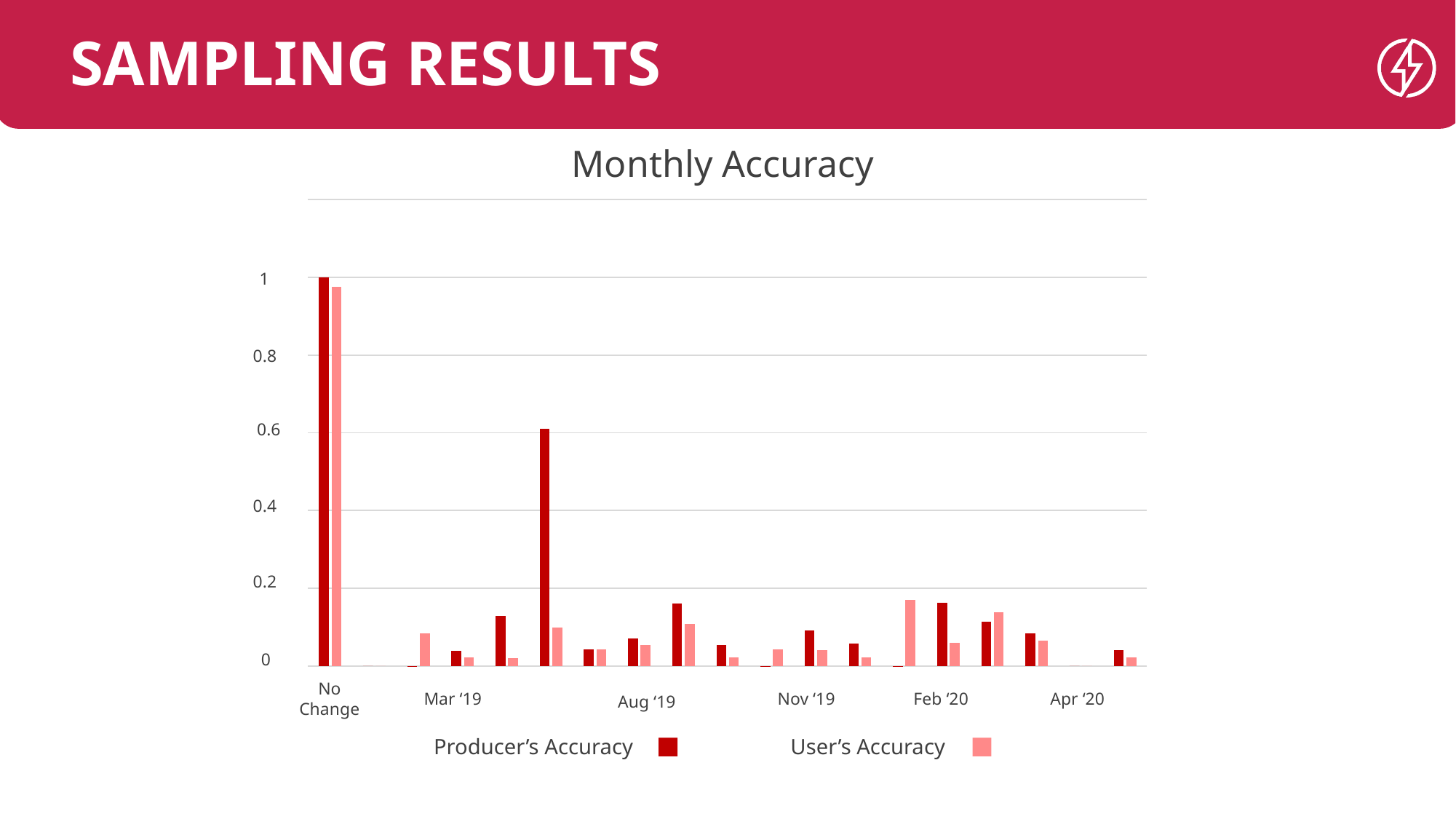
Is the Producer's Accuracy for No Change greater or less than 0.8? greater Which category has the highest Producer's Accuracy? No Change Is the User's Accuracy for Aug '19 greater or less than 0.2? less For Feb '20, which is larger: Producer's Accuracy or User's Accuracy? Producer's Accuracy Is the User's Accuracy for No Change greater or less than 0.8? greater How many category labels are shown on the x axis of the Monthly Accuracy chart? 6 Which category has the highest User's Accuracy? No Change Which series is shown in dark red in the Monthly Accuracy chart? Producer's Accuracy What is the title of the chart? Monthly Accuracy How many series does the legend of the Monthly Accuracy chart list? 2 What type of chart is shown on the slide? bar chart